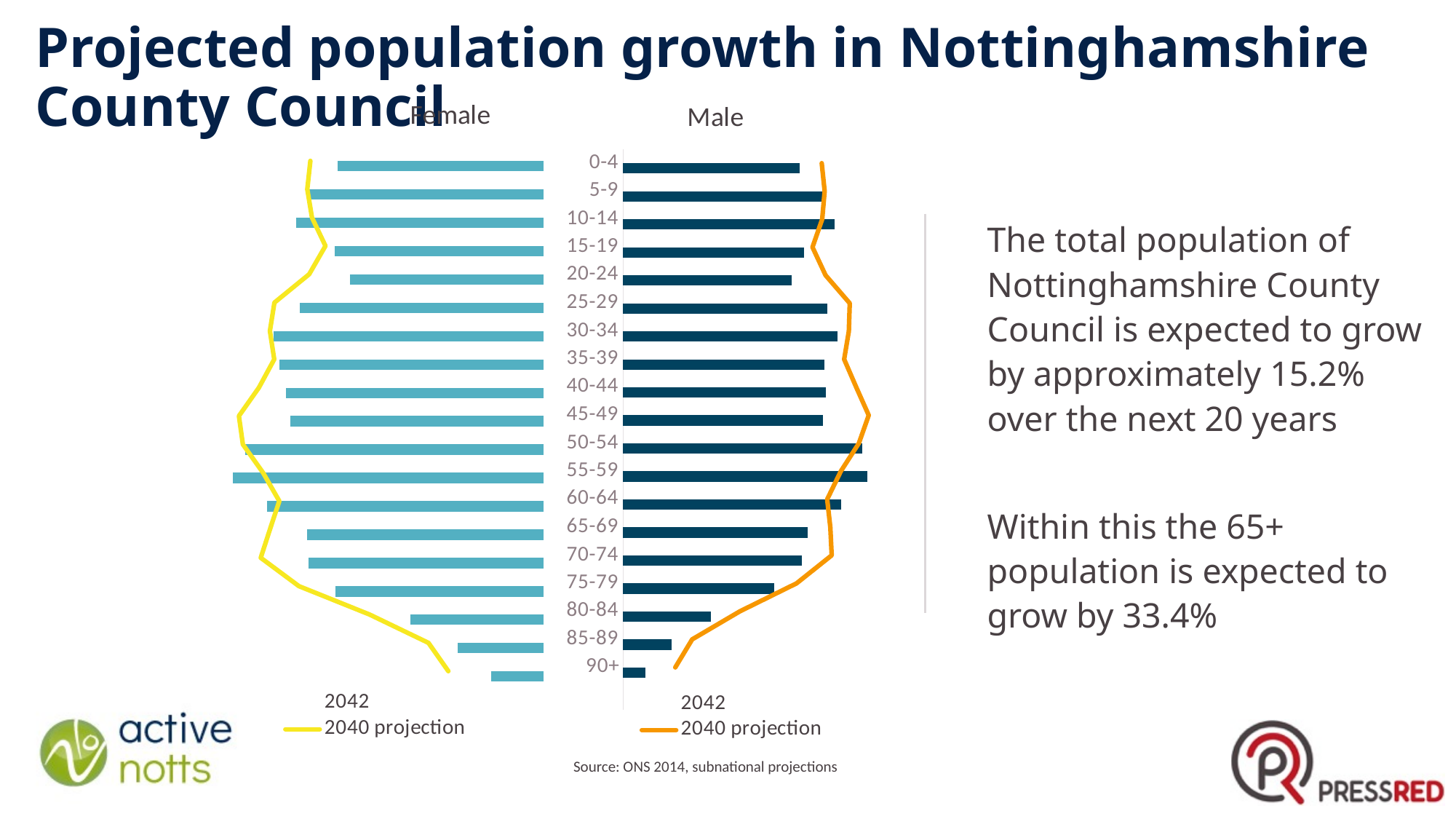
How many series does the legend list for the Female chart? 2 What are the two legend entries shown under the Male chart? 2042 and 2040 projection On the Female chart, which age group has the longest 2042 bar? 55-59 On the Male chart, which 2042 bar is longer: 20-24 or 30-34? 30-34 On the Male chart, do the 2042 bars rise or fall from the 65-69 age group to the 90+ age group? fall On the Male chart, which 2042 bar is longer: 80-84 or 85-89? 80-84 How many age groups are listed on the chart? 19 On the Female chart, which age group has the shortest 2042 bar? 90+ What colour is the 2040 projection line on the Female chart? yellow What kind of chart is used to show the 2042 population by age group? bar chart On the Female chart, which 2042 bar is longer: 0-4 or 55-59? 55-59 On the Male chart, which age group has the shortest 2042 bar? 90+